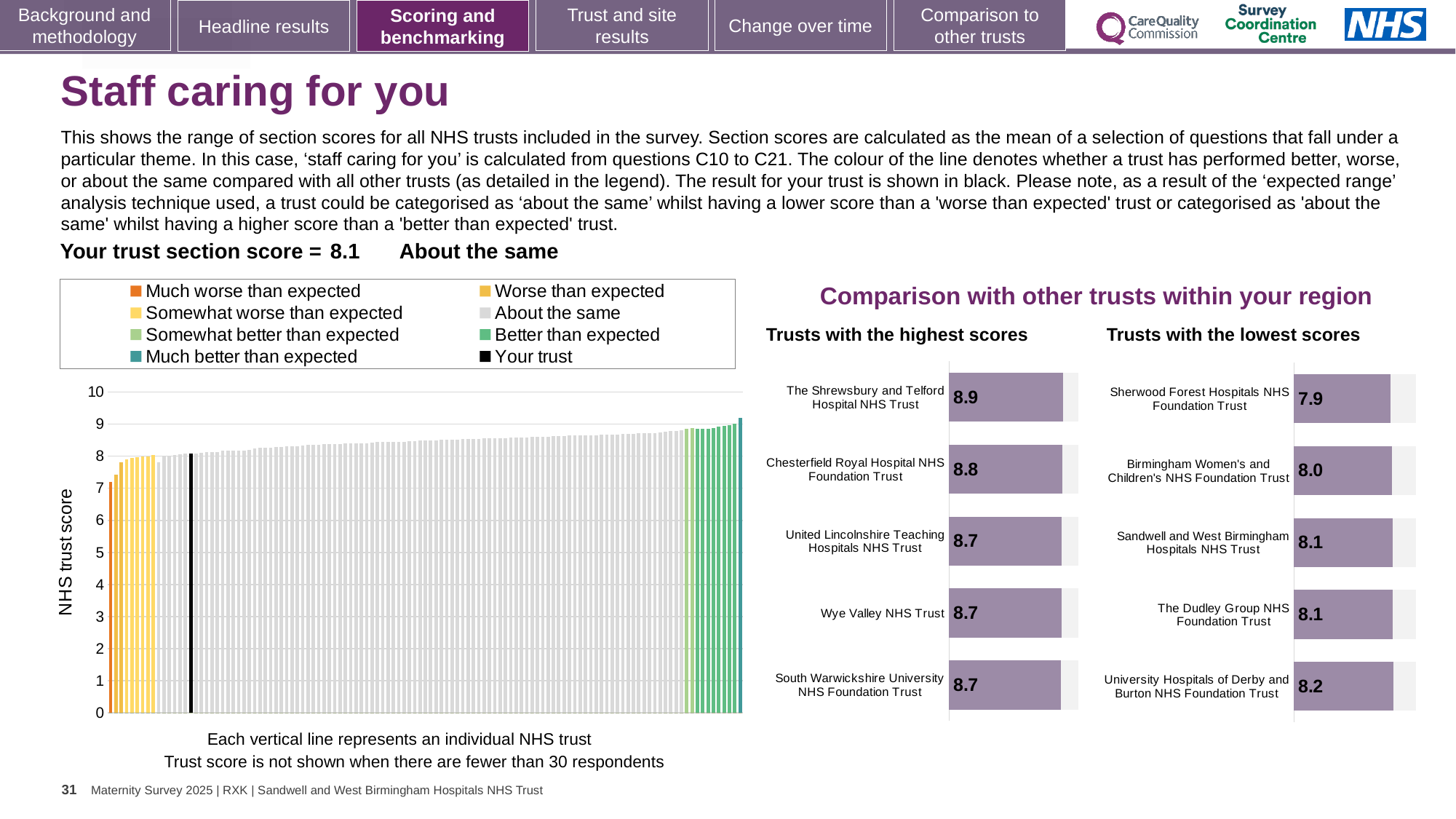
How many entries does the legend above the large chart on the left list? 8 In the 'Trusts with the highest scores' chart, what is the score for The Shrewsbury and Telford Hospital NHS Trust? 8.9 In the 'Trusts with the highest scores' chart, what is the difference between the scores of The Shrewsbury and Telford Hospital NHS Trust and Chesterfield Royal Hospital NHS Foundation Trust? 0.1 In the 'Trusts with the lowest scores' chart, what is the score for Sherwood Forest Hospitals NHS Foundation Trust? 7.9 What kind of chart is the large chart on the left showing NHS trust scores? bar chart In the large chart on the left, what is the section score for your trust (shown in black)? 8.1 In the 'Trusts with the lowest scores' chart, which has the higher score: Birmingham Women's and Children's NHS Foundation Trust or University Hospitals of Derby and Burton NHS Foundation Trust? University Hospitals of Derby and Burton NHS Foundation Trust In the 'Trusts with the lowest scores' chart, which trust has the lowest score? Sherwood Forest Hospitals NHS Foundation Trust How many trusts are shown in the 'Trusts with the highest scores' chart? 5 In the large chart on the left, do the trust scores rise or fall from left to right? rise In the 'Trusts with the lowest scores' chart, what is the difference between the scores of University Hospitals of Derby and Burton NHS Foundation Trust and Sherwood Forest Hospitals NHS Foundation Trust? 0.3 In the 'Trusts with the highest scores' chart, which trust has the highest score? The Shrewsbury and Telford Hospital NHS Trust